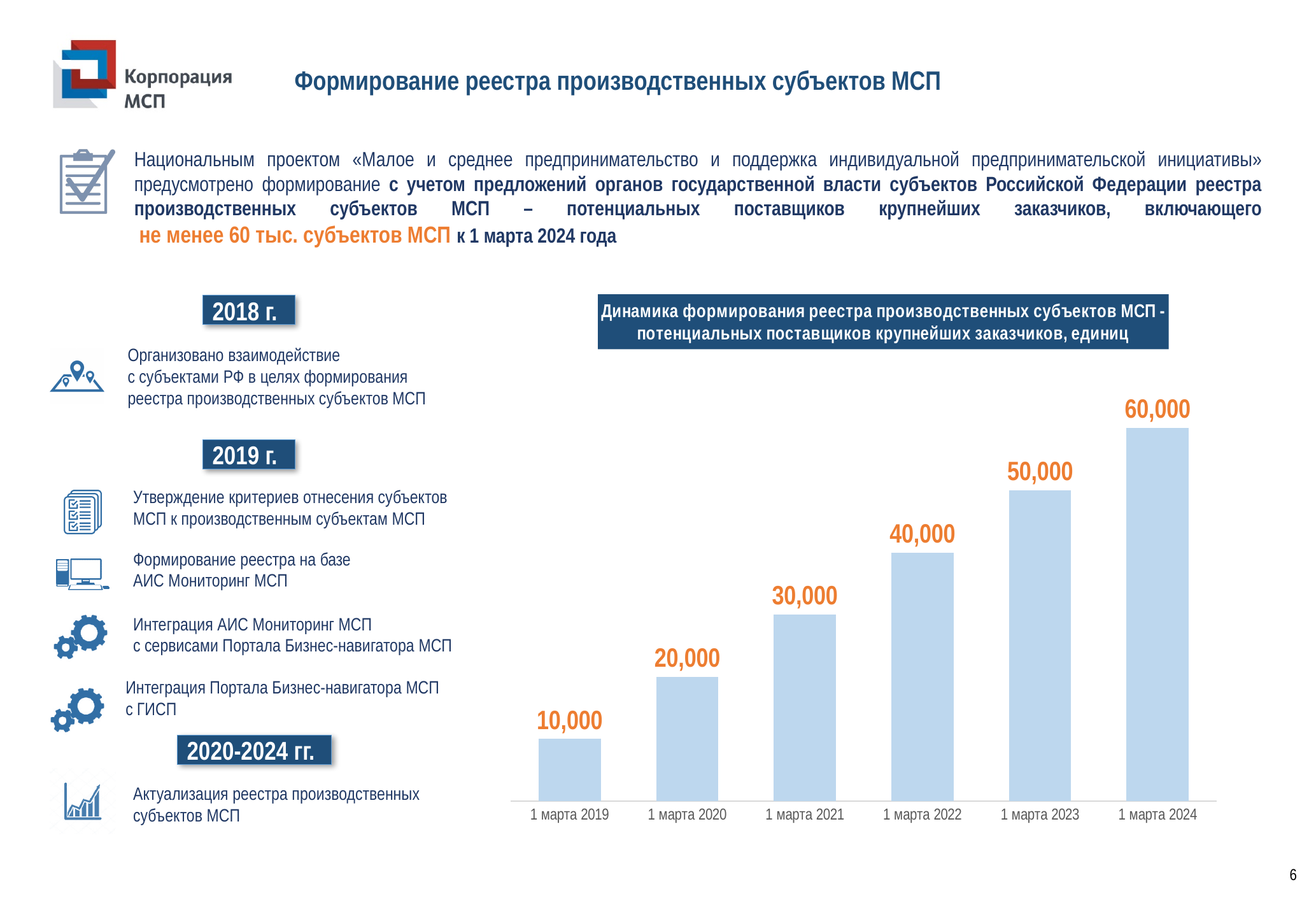
What is the title of the chart? Динамика формирования реестра производственных субъектов МСП - потенциальных поставщиков крупнейших заказчиков, единиц What is the value for 1 марта 2021? 30,000 What is the value for 1 марта 2024? 60,000 Which category has the lowest value? 1 марта 2019 What is the difference between the values for 1 марта 2024 and 1 марта 2019? 50,000 Which is larger, the value for 1 марта 2022 or the value for 1 марта 2021? 1 марта 2022 How many categories are shown on the x axis? 6 Do the values rise or fall from 1 марта 2019 to 1 марта 2024? rise What kind of chart is shown? bar chart What is the value for 1 марта 2019? 10,000 What is the difference between the values for 1 марта 2023 and 1 марта 2020? 30,000 Which category has the highest value? 1 марта 2024